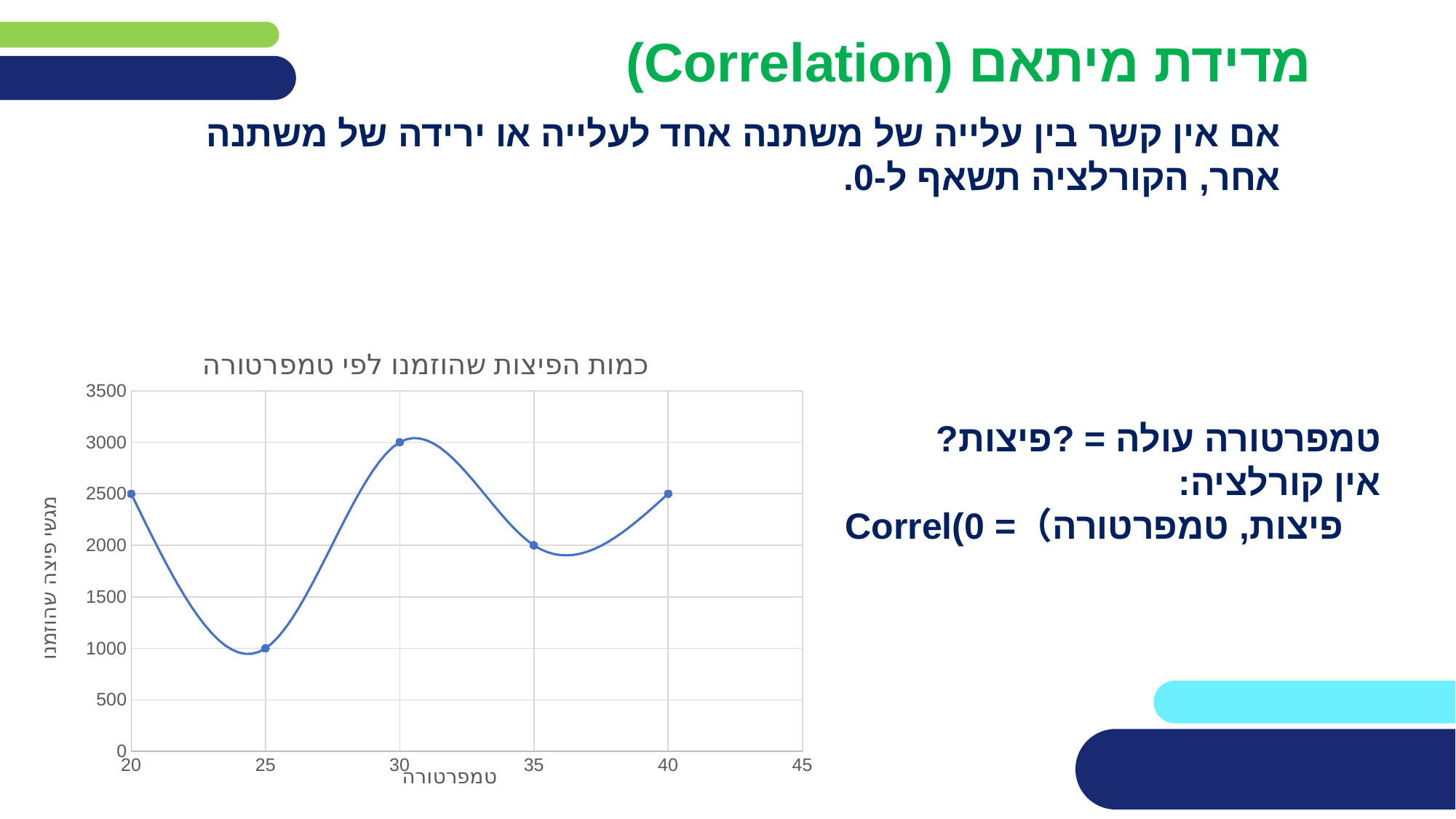
What is the label of the x axis of the chart? טמפרטורה What type of chart is shown on the slide? Line chart What is the value plotted at temperature 30? 3000 At which temperature is the plotted value lowest? 25 What is the difference between the values at temperature 30 and temperature 25? 2000 Do the plotted values consistently rise, consistently fall, or fluctuate as temperature increases along the x axis? Fluctuate What is the title of the chart? כמות הפיצות שהוזמנו לפי טמפרטורה How many data points are plotted on the chart? 5 At which temperature is the plotted value highest? 30 Which is larger, the value at temperature 20 or the value at temperature 35? Temperature 20 What is the value plotted at temperature 25? 1000 What is the value plotted at temperature 35? 2000